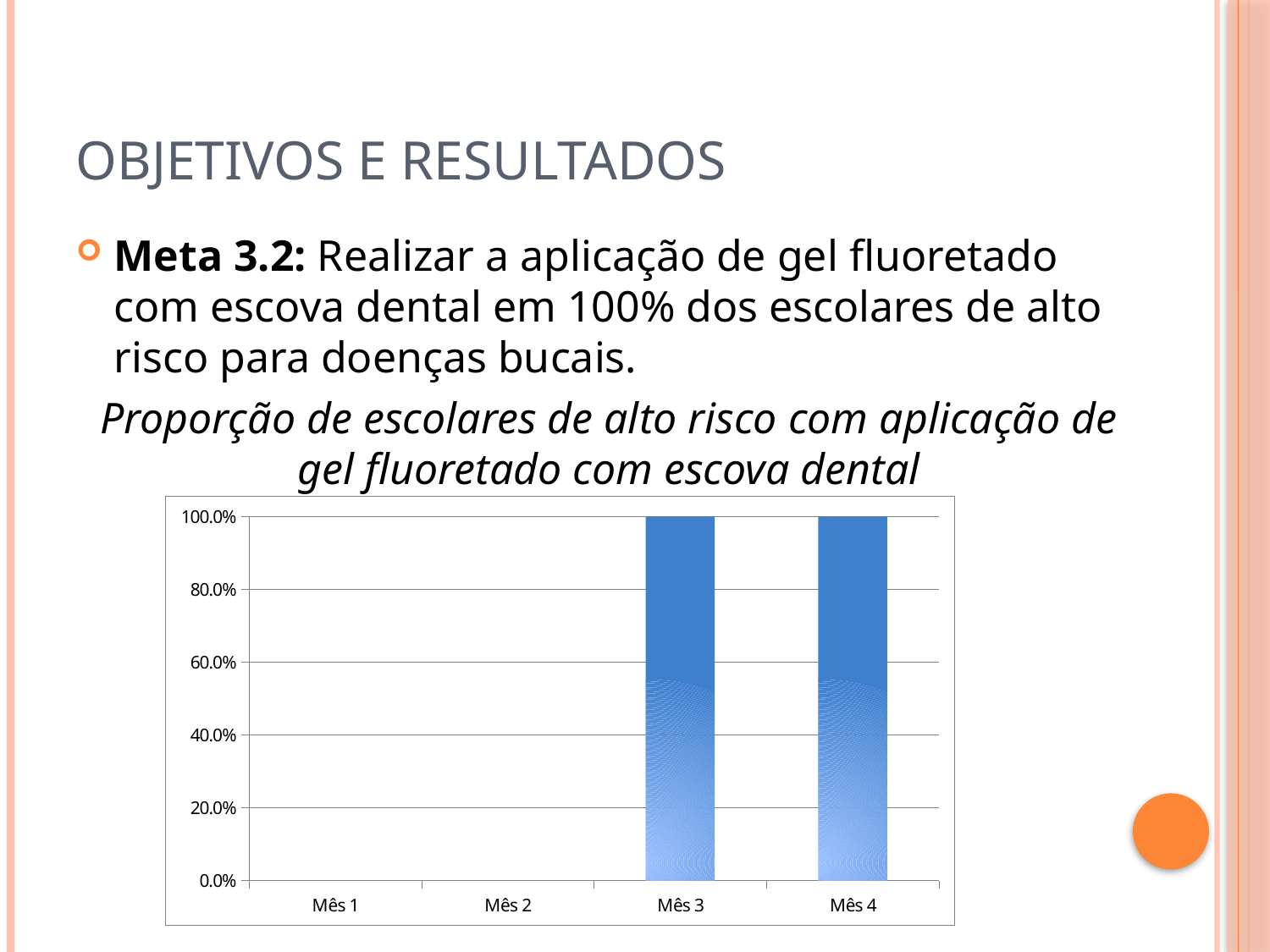
What is the title of the chart? Proporção de escolares de alto risco com aplicação de gel fluoretado com escova dental What is the value for Mês 2 in the chart? 0.0% How many categories (months) are shown on the x axis of the chart? 4 How many months in the chart reach 100.0%? 2 What is the value for Mês 3 in the chart? 100.0% Is the value for Mês 4 greater or less than 80.0%? greater What kind of chart is shown on the slide? bar chart What is the value for Mês 1 in the chart? 0.0% Do the values rise or fall from Mês 1 to Mês 4? rise Which has the larger value, Mês 2 or Mês 3? Mês 3 What is the value for Mês 4 in the chart? 100.0% What is the difference between the values for Mês 3 and Mês 1? 100.0%